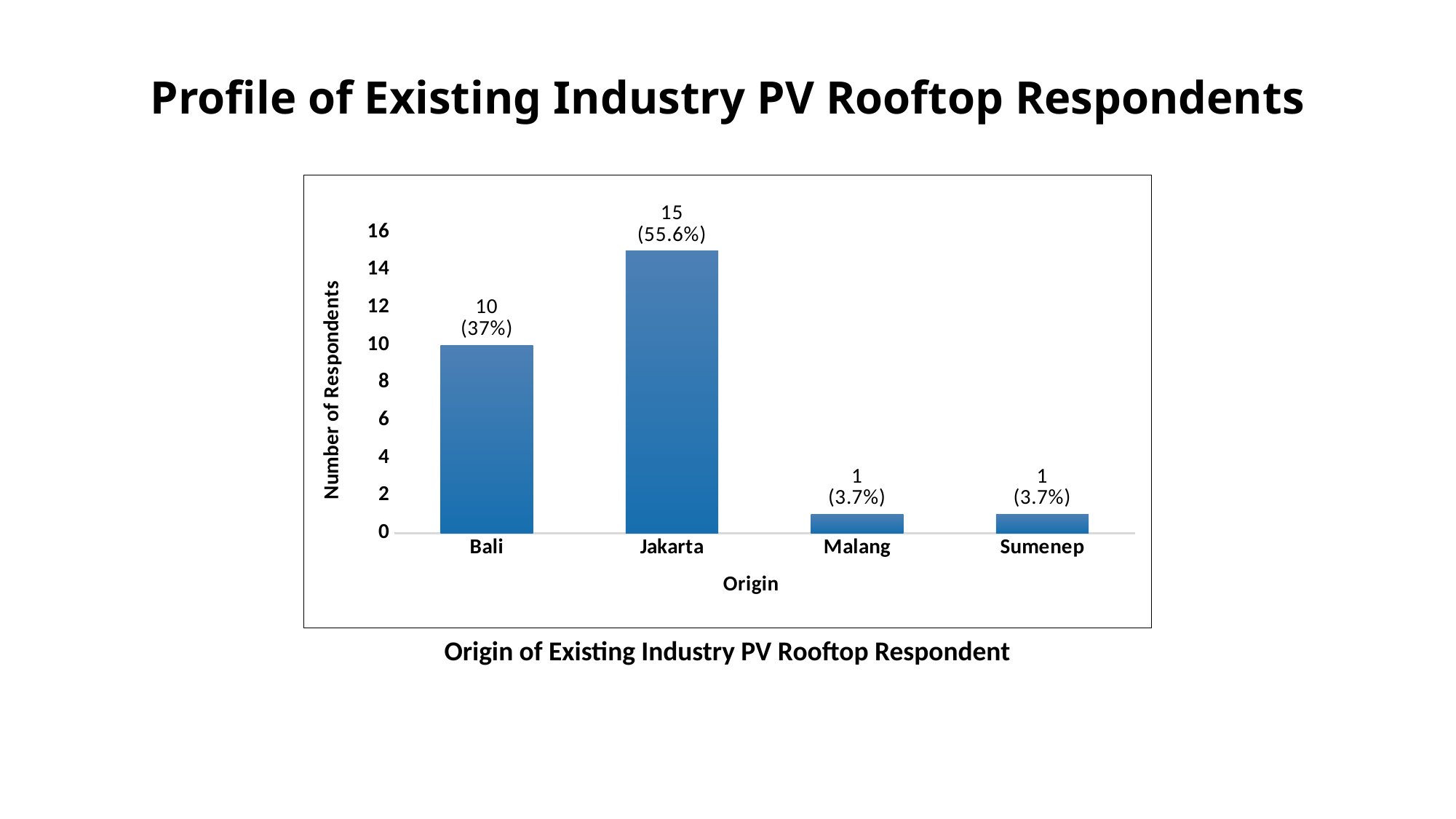
What kind of chart is shown on the slide? Bar chart How many respondents are from Bali? 10 What is the label of the y axis? Number of Respondents How many origin categories are shown on the x axis? 4 What percentage of respondents are from Malang? 3.7% What percentage of respondents are from Bali? 37% How many respondents are from Jakarta? 15 Which origin has the highest number of respondents? Jakarta Is the number of respondents from Jakarta greater or less than 14? greater What is the caption below the chart? Origin of Existing Industry PV Rooftop Respondent Which has more respondents, Bali or Sumenep? Bali What is the difference in the number of respondents between Jakarta and Bali? 5